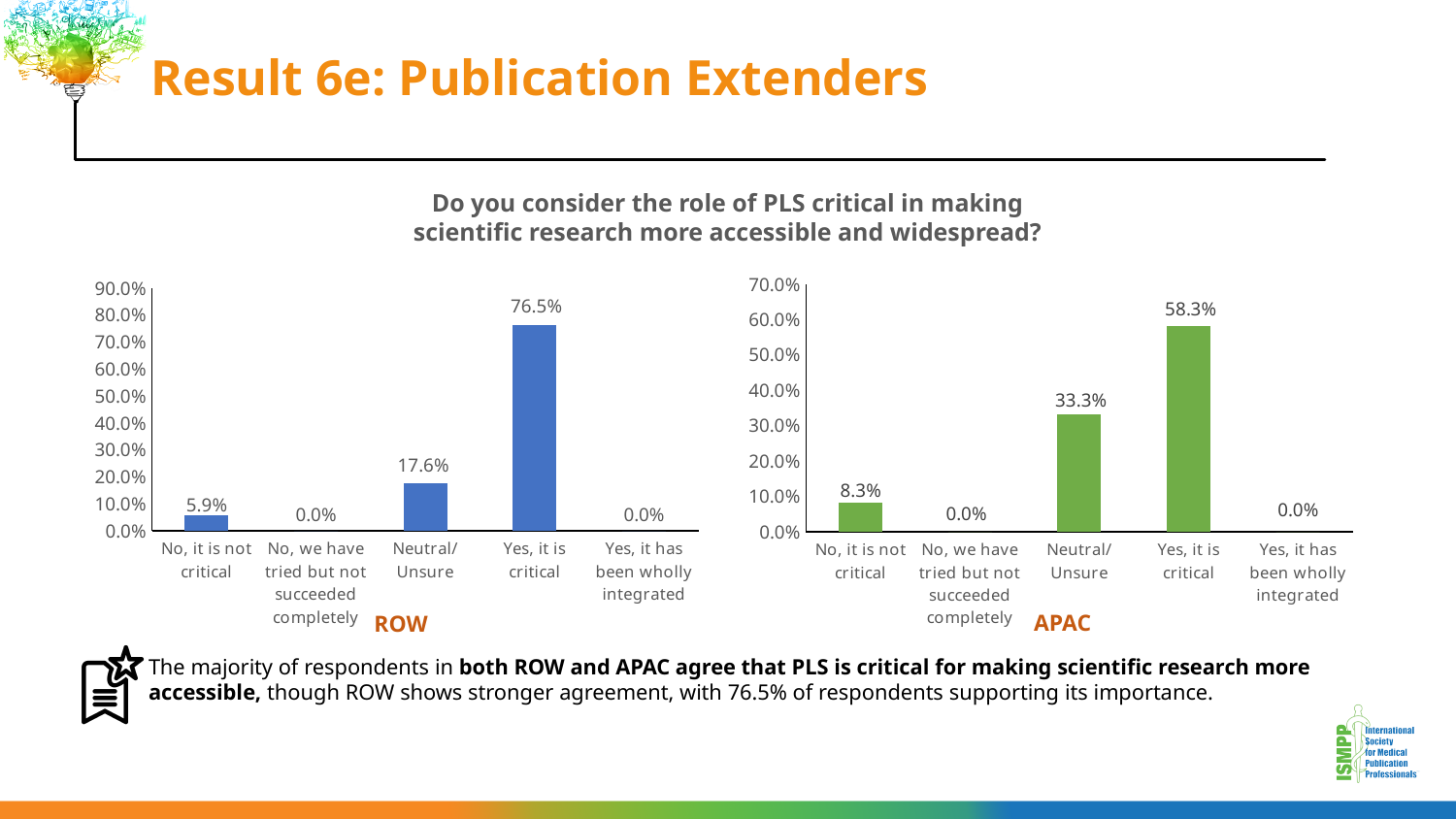
How many categories are shown on the x axis of the APAC chart? 5 What type of chart is the ROW chart? Bar chart In the APAC chart, what is the value for "No, it is not critical"? 8.3% In the ROW chart, what is the value for "Yes, it is critical"? 76.5% In the APAC chart, what is the difference between "Yes, it is critical" and "Neutral/Unsure"? 25.0% In the ROW chart, is the value for "Neutral/Unsure" greater or less than 20.0%? less Which is larger: the "Yes, it is critical" value in the ROW chart or in the APAC chart? ROW What colour are the bars in the APAC chart? Green In the ROW chart, what is the difference between "Yes, it is critical" and "Neutral/Unsure"? 58.9% In the APAC chart, which category has the highest value? Yes, it is critical In the APAC chart, what is the value for "Neutral/Unsure"? 33.3% In the ROW chart, which category has the highest value? Yes, it is critical